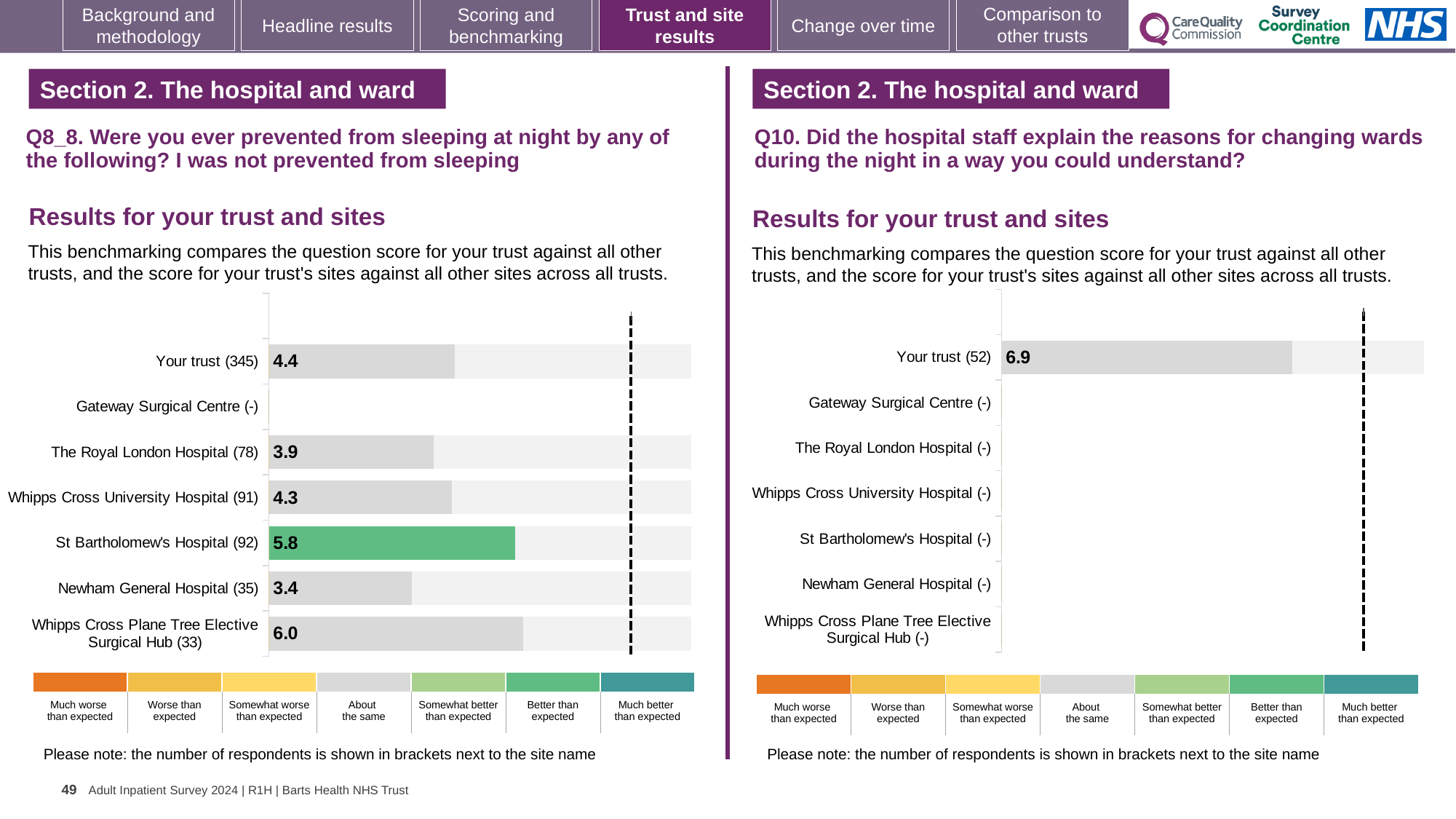
On the Q8_8 chart (left), which site's bar is coloured green? St Bartholomew's Hospital On the Q8_8 chart (left), what is the difference between the scores for St Bartholomew's Hospital and The Royal London Hospital? 1.9 On the Q8_8 chart (left), how many respondents are shown for Your trust? 345 On the Q8_8 chart (left), which site has the highest score? Whipps Cross Plane Tree Elective Surgical Hub On the Q8_8 chart (left), which site has the lowest score? Newham General Hospital On the Q10 chart (right), what is the score for Your trust? 6.9 On the Q8_8 chart (left), what is the score for Newham General Hospital? 3.4 On the Q8_8 chart (left), what is the score for Your trust? 4.4 What type of chart is used on the Q8_8 chart (left)? Bar chart On the Q8_8 chart (left), which has the higher score, Whipps Cross University Hospital or The Royal London Hospital? Whipps Cross University Hospital On the Q8_8 chart (left), what is the score for St Bartholomew's Hospital? 5.8 On the Q10 chart (right), how many respondents are shown for Your trust? 52